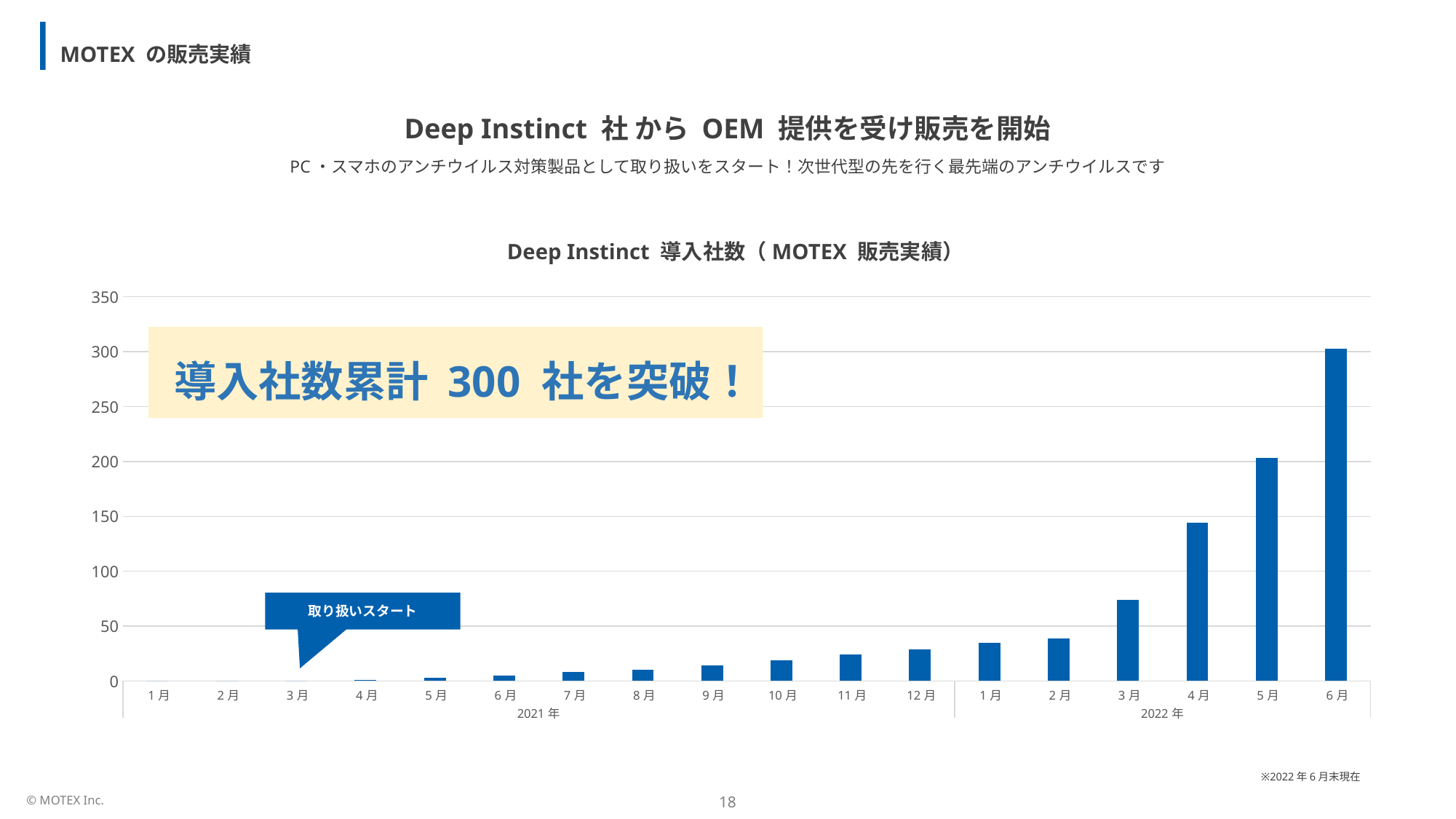
Which month has the tallest bar in the chart? 2022年 6月 Is the value for 2022年 6月 greater or less than 250? greater Is the value for 2022年 5月 greater or less than 150? greater What is the title of the chart? Deep Instinct 導入社数（MOTEX 販売実績） What kind of chart is shown on the slide? bar chart Which is larger, the value for 2022年 4月 or the value for 2022年 2月? 2022年 4月 Is the value for 2022年 3月 greater or less than 50? greater How many months (categories) are shown on the x axis of the chart? 18 Do the values generally rise or fall from left to right along the x axis? rise At which month does the callout '取り扱いスタート' point on the x axis? 2021年 3月